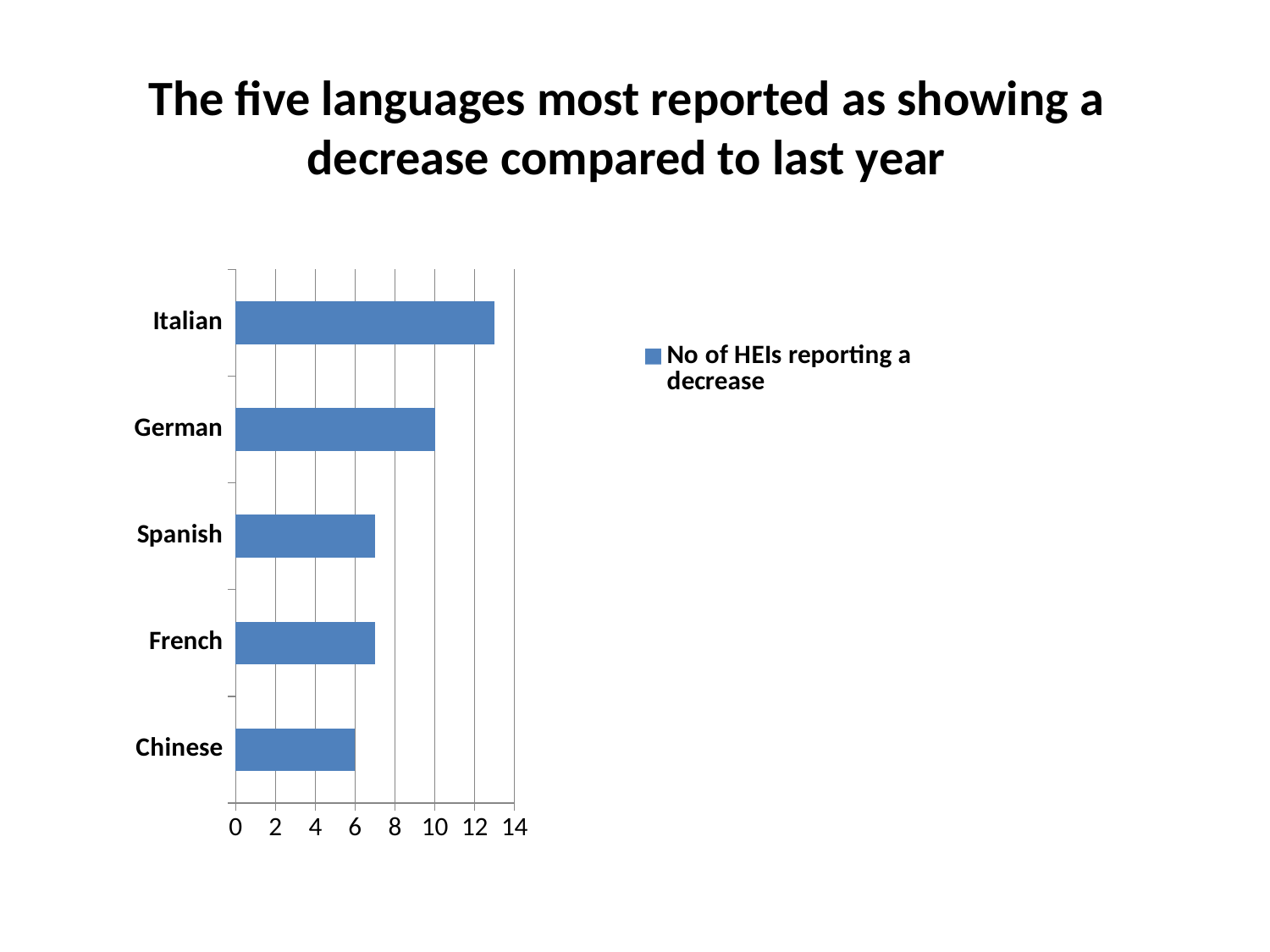
What is the number of HEIs reporting a decrease for German? 10 Which has more HEIs reporting a decrease, Italian or German? Italian What is the legend entry for the series shown in the chart? No of HEIs reporting a decrease Which language has the highest number of HEIs reporting a decrease? Italian What is the difference between the values for German and Chinese? 4 How many series does the legend list? 1 What kind of chart is shown on the slide? Bar chart How many languages are shown in the chart? 5 Is the value for Italian greater or less than 12? greater Is the value for Spanish greater or less than 8? less Which language has the lowest number of HEIs reporting a decrease? Chinese What is the number of HEIs reporting a decrease for Chinese? 6